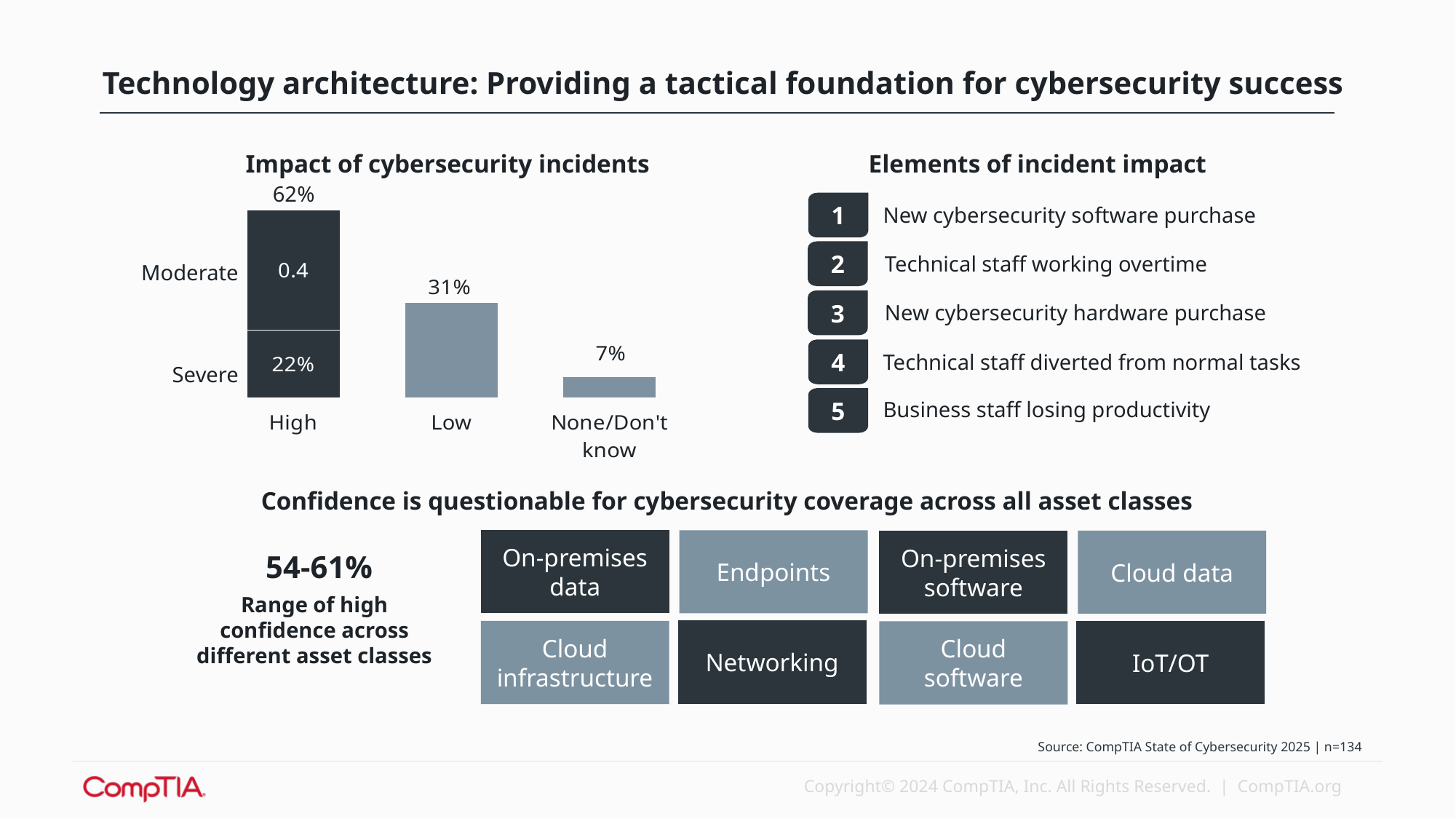
In the 'Impact of cybersecurity incidents' chart, how many categories are shown on the x axis? 3 In the 'Impact of cybersecurity incidents' chart, which category has the highest value? High In the 'Impact of cybersecurity incidents' chart, which is larger: the value for Low or the value for None/Don't know? Low In the 'Impact of cybersecurity incidents' chart, what label is printed on the Moderate segment of the High bar? 0.4 In the 'Impact of cybersecurity incidents' chart, what is the difference between the Low value and the None/Don't know value? 24% In the 'Impact of cybersecurity incidents' chart, which category has the lowest value? None/Don't know In the 'Impact of cybersecurity incidents' chart, what is the value for None/Don't know? 7% In the 'Impact of cybersecurity incidents' chart, do the values rise or fall moving from High to None/Don't know? fall In the 'Impact of cybersecurity incidents' chart, what is the value for Low? 31% In the 'Impact of cybersecurity incidents' chart, what is the total shown for the High bar? 62% What kind of chart is 'Impact of cybersecurity incidents'? bar chart In the 'Impact of cybersecurity incidents' chart, what is the value of the Severe segment of the High bar? 22%